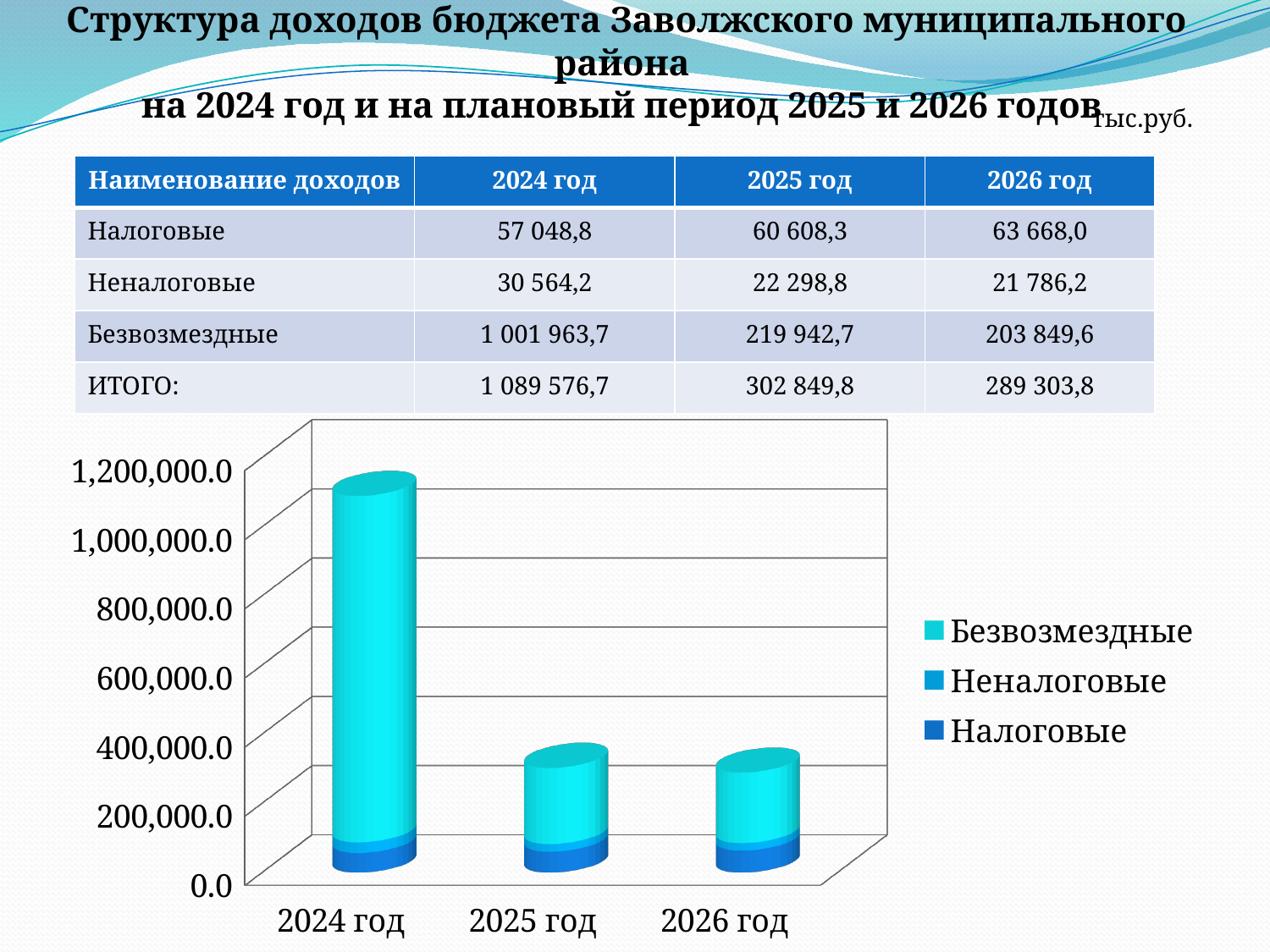
What kind of chart is shown on the slide? bar chart How many series does the chart legend list? 3 Which legend entry is listed first in the chart legend? Безвозмездные Do the total bar heights rise or fall from 2024 год to 2026 год? fall How many year categories are shown on the x axis of the chart? 3 Which year has the tallest stacked bar in the chart? 2024 год According to the table, what is the difference between Безвозмездные in 2024 год and in 2025 год? 782 021,0 Is the total height of the bar for 2024 год greater or less than 1,000,000.0? greater According to the table, what is the value of Безвозмездные for 2026 год? 203 849,6 Is the total height of the bar for 2025 год greater or less than 400,000.0? less According to the table, which is larger: Неналоговые in 2024 год or Неналоговые in 2025 год? 2024 год According to the table, what is the total (ИТОГО) for 2024 год? 1 089 576,7